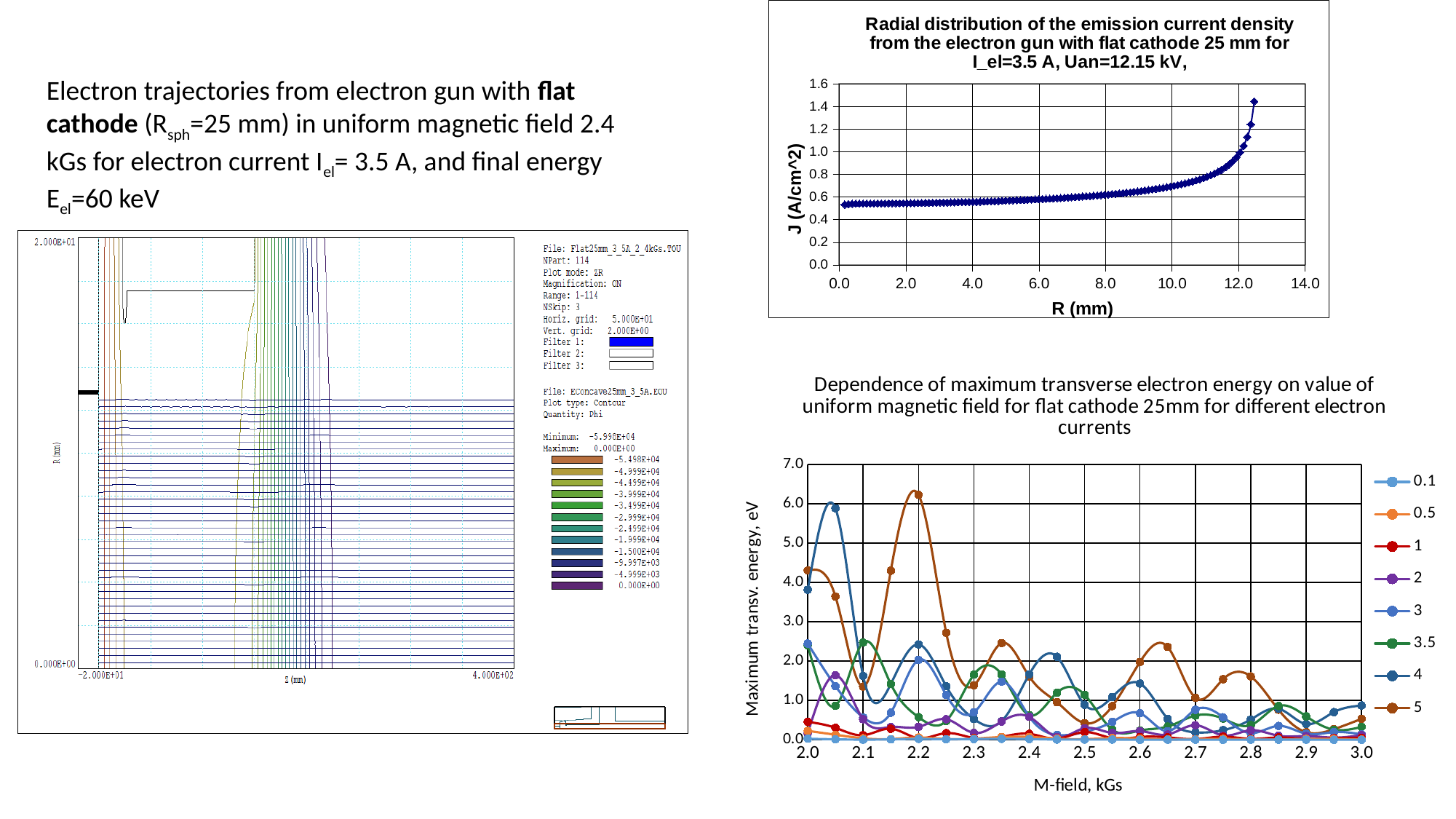
In the chart titled 'Dependence of maximum transverse electron energy on value of uniform magnetic field', how many series does the legend list? 8 In the chart titled 'Dependence of maximum transverse electron energy on value of uniform magnetic field', what is the label of the horizontal axis? M-field, kGs In the chart titled 'Dependence of maximum transverse electron energy on value of uniform magnetic field', which series has the highest value at M-field 2.2 kGs? 5 In the chart titled 'Radial distribution of the emission current density', what is the label of the vertical axis? J (A/cm^2) In the chart titled 'Dependence of maximum transverse electron energy on value of uniform magnetic field', is the value of series 5 at M-field 2.2 kGs greater or less than 5.0? greater In the chart titled 'Radial distribution of the emission current density', what is the largest value shown on the horizontal axis? 14.0 In the chart titled 'Radial distribution of the emission current density', is the highest plotted value of J greater or less than 1.2? greater In the chart titled 'Radial distribution of the emission current density', is the value of J at R = 0.0 mm greater or less than 1.0? less In the chart titled 'Radial distribution of the emission current density', does J rise or fall as R increases? rise In the chart titled 'Dependence of maximum transverse electron energy on value of uniform magnetic field', do the peak values of series 5 rise or fall as M-field increases from 2.0 to 3.0 kGs? fall What kind of chart is the one titled 'Dependence of maximum transverse electron energy on value of uniform magnetic field'? line chart